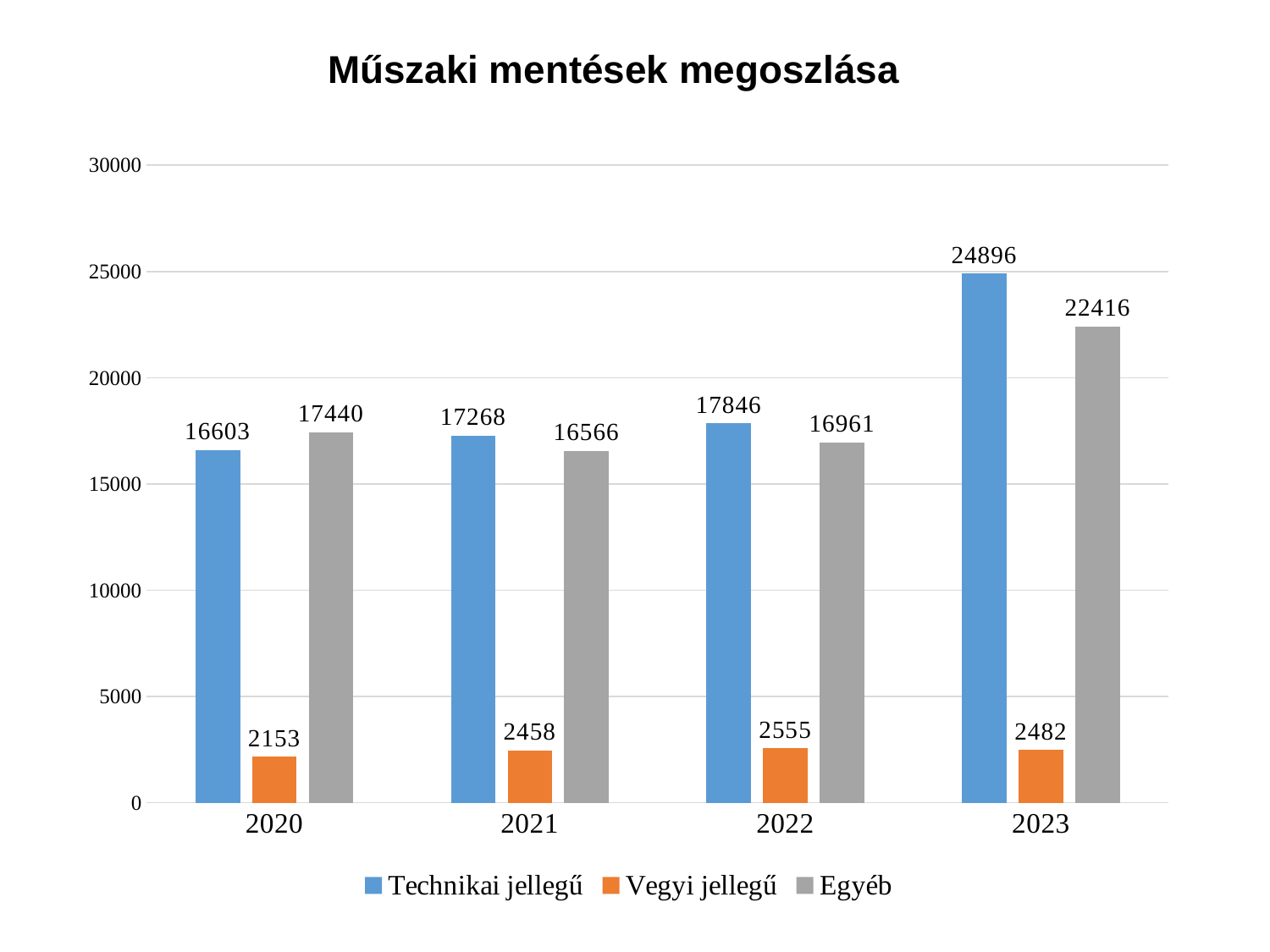
In which year is the Technikai jellegű value highest? 2023 Is the value for Egyéb in 2023 greater or less than 20000? greater What is the title of the chart? Műszaki mentések megoszlása How many years are shown on the x axis? 4 How many series does the legend list? 3 Which is larger in 2020: Technikai jellegű or Egyéb? Egyéb What is the value for Vegyi jellegű in 2020? 2153 What kind of chart is shown? bar chart What is the value for Technikai jellegű in 2023? 24896 In which year is the Vegyi jellegű value lowest? 2020 What is the value for Egyéb in 2021? 16566 What is the difference between the Technikai jellegű and Egyéb values in 2023? 2480